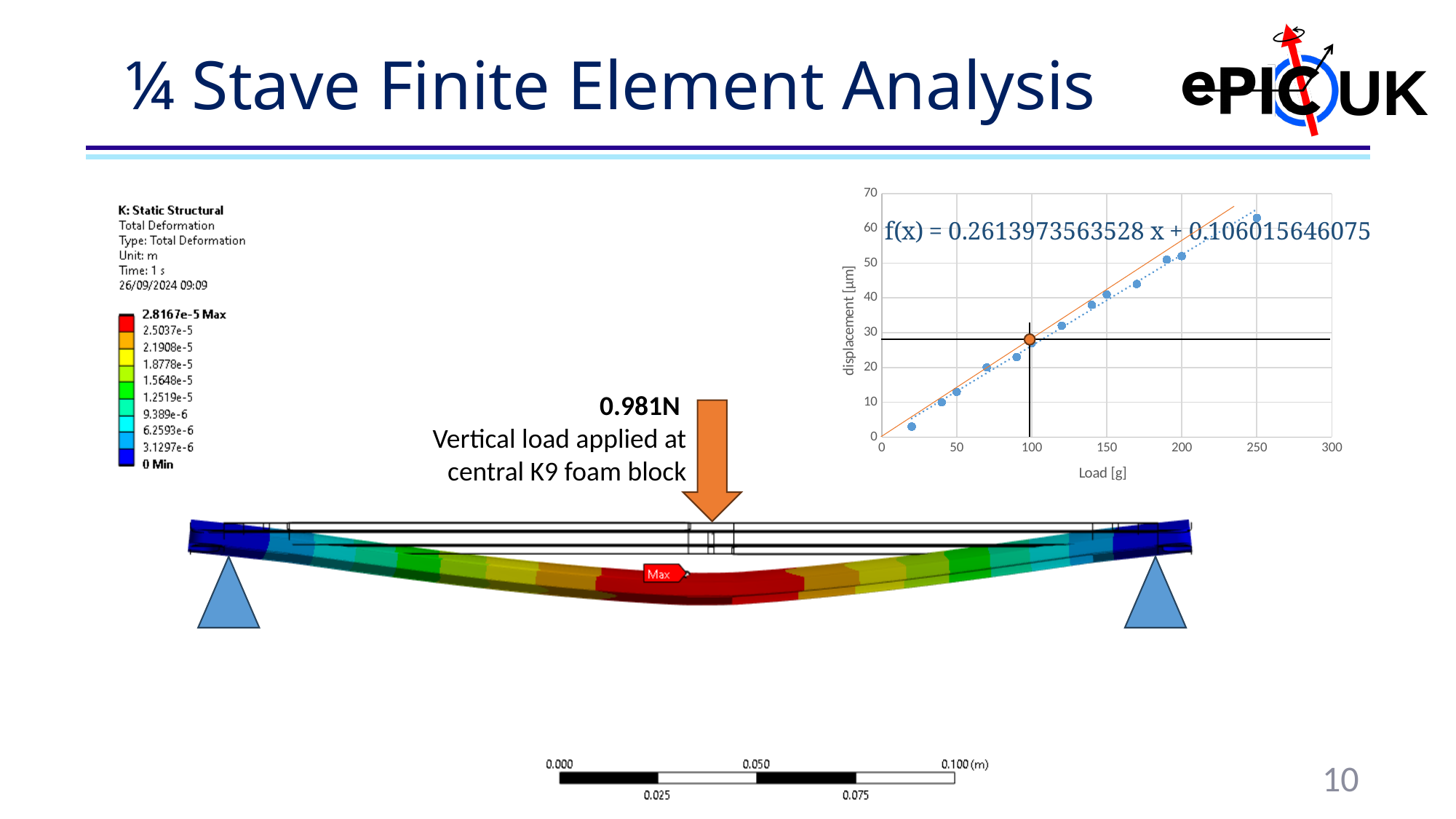
In the scatter chart, at which load is the displacement highest? 250 g What is the label of the x axis of the scatter chart? Load [g] In the scatter chart, is the displacement at a load of 140 g greater or less than 30? greater What is the slope of the fitted line equation shown on the scatter chart? 0.2613973563528 In the scatter chart, at which load is the displacement lowest? 20 g In the scatter chart, is the displacement at a load of 20 g greater or less than 10? less In the scatter chart, which has the larger displacement: the point at 250 g or the point at 20 g? 250 g In the scatter chart, is the displacement at a load of 50 g greater or less than 20? less In the scatter chart, does displacement rise or fall as load increases? rise What kind of chart is shown on the right of the slide? scatter chart